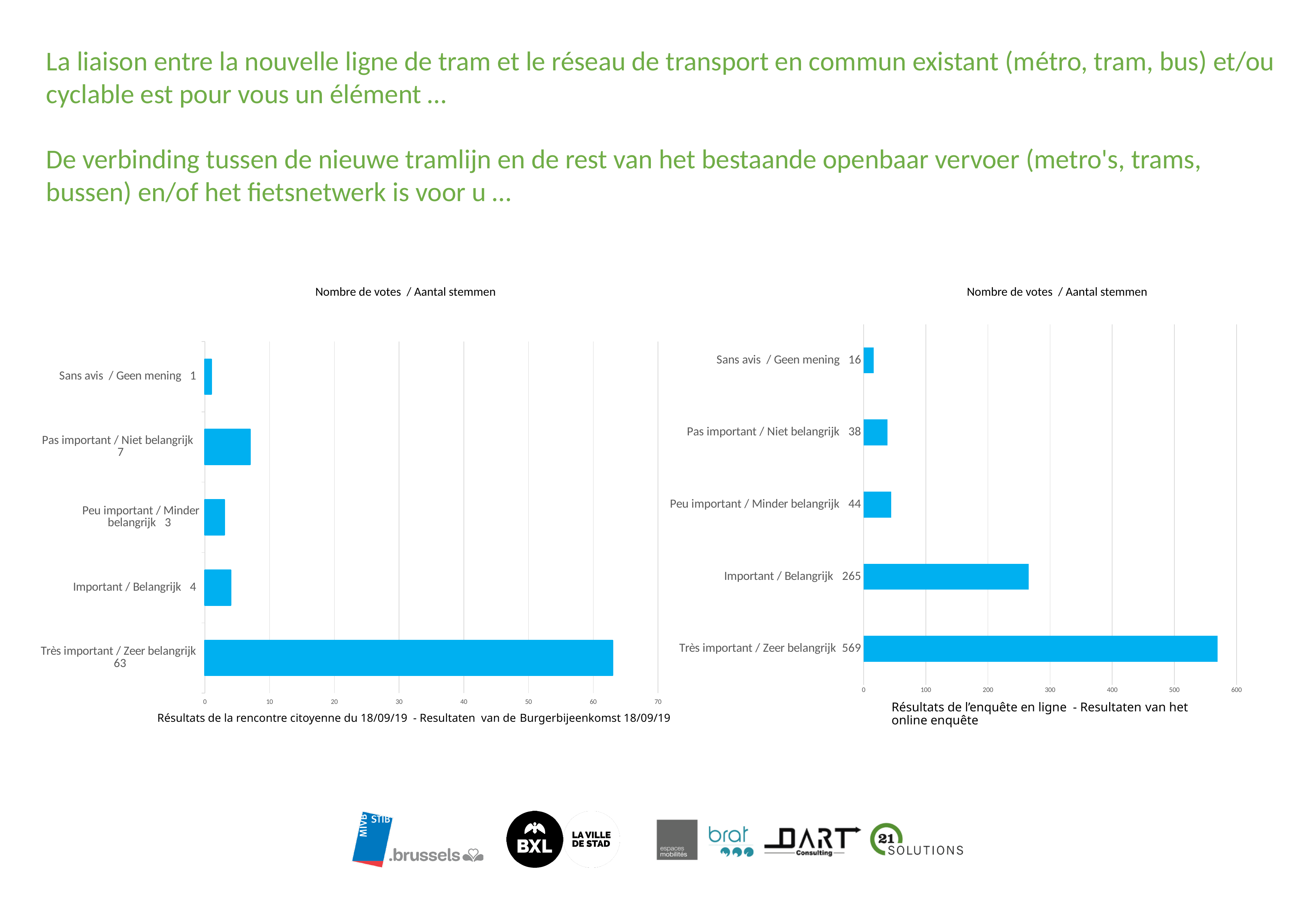
In the left chart (Résultats de la rencontre citoyenne du 18/09/19), what is the total number of votes across all categories? 78 In the right chart (Résultats de l'enquête en ligne), how many votes did 'Important / Belangrijk' receive? 265 In the right chart (Résultats de l'enquête en ligne), is the value for 'Important / Belangrijk' greater or less than 200? greater In the right chart (Résultats de l'enquête en ligne), what is the difference in votes between 'Très important / Zeer belangrijk' and 'Important / Belangrijk'? 304 In the left chart (Résultats de la rencontre citoyenne du 18/09/19), how many votes did 'Très important / Zeer belangrijk' receive? 63 In the right chart (Résultats de l'enquête en ligne), how many votes did 'Sans avis / Geen mening' receive? 16 What is the title shown above each of the two charts? Nombre de votes / Aantal stemmen In the right chart (Résultats de l'enquête en ligne), which category has the highest number of votes? Très important / Zeer belangrijk In the left chart (Résultats de la rencontre citoyenne du 18/09/19), which has more votes: 'Pas important / Niet belangrijk' or 'Important / Belangrijk'? Pas important / Niet belangrijk In the left chart (Résultats de la rencontre citoyenne du 18/09/19), which category has the lowest number of votes? Sans avis / Geen mening What kind of chart is the right chart (Résultats de l'enquête en ligne)? bar chart How many categories are shown in the left chart (Résultats de la rencontre citoyenne du 18/09/19)? 5